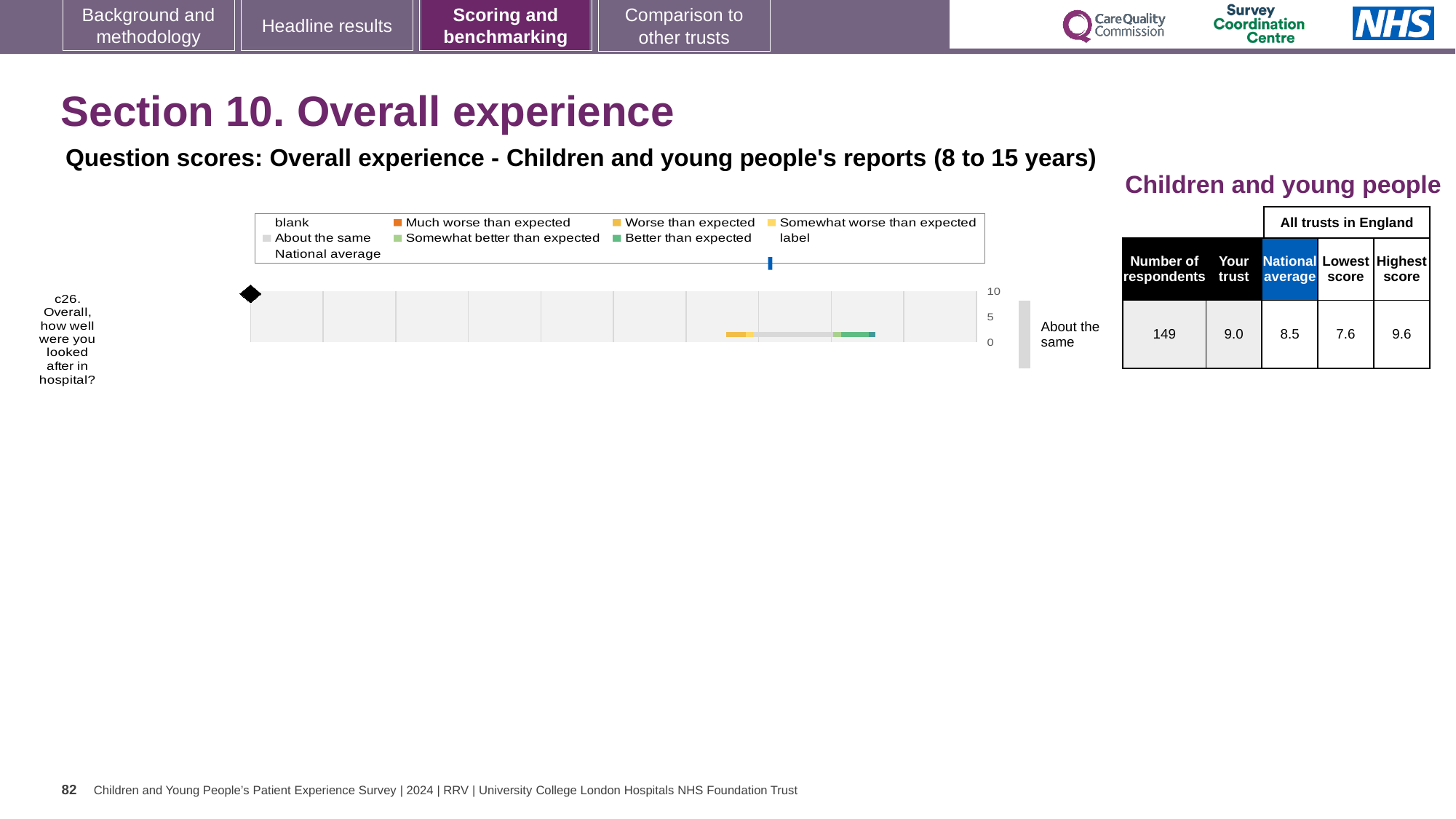
For question c26, what is the difference between the highest score and the lowest score among all trusts in England? 2.0 For question c26, how much higher is the 'Your trust' score than the national average? 0.5 In the table beside the chart, what is the national average score for question c26? 8.5 How many survey questions are plotted on the chart? 1 What is the highest tick value shown on the chart's axis? 10 What benchmark category label is shown to the right of the bar for question c26? About the same In the table beside the chart, what is the 'Your trust' score for question c26? 9.0 In the table beside the chart, how many respondents answered question c26? 149 What kind of chart is used to show the benchmarking result for question c26? Bar chart In the table beside the chart, what is the highest score among all trusts in England for question c26? 9.6 For question c26, which is larger: the 'Your trust' score or the national average? Your trust In the table beside the chart, what is the lowest score among all trusts in England for question c26? 7.6